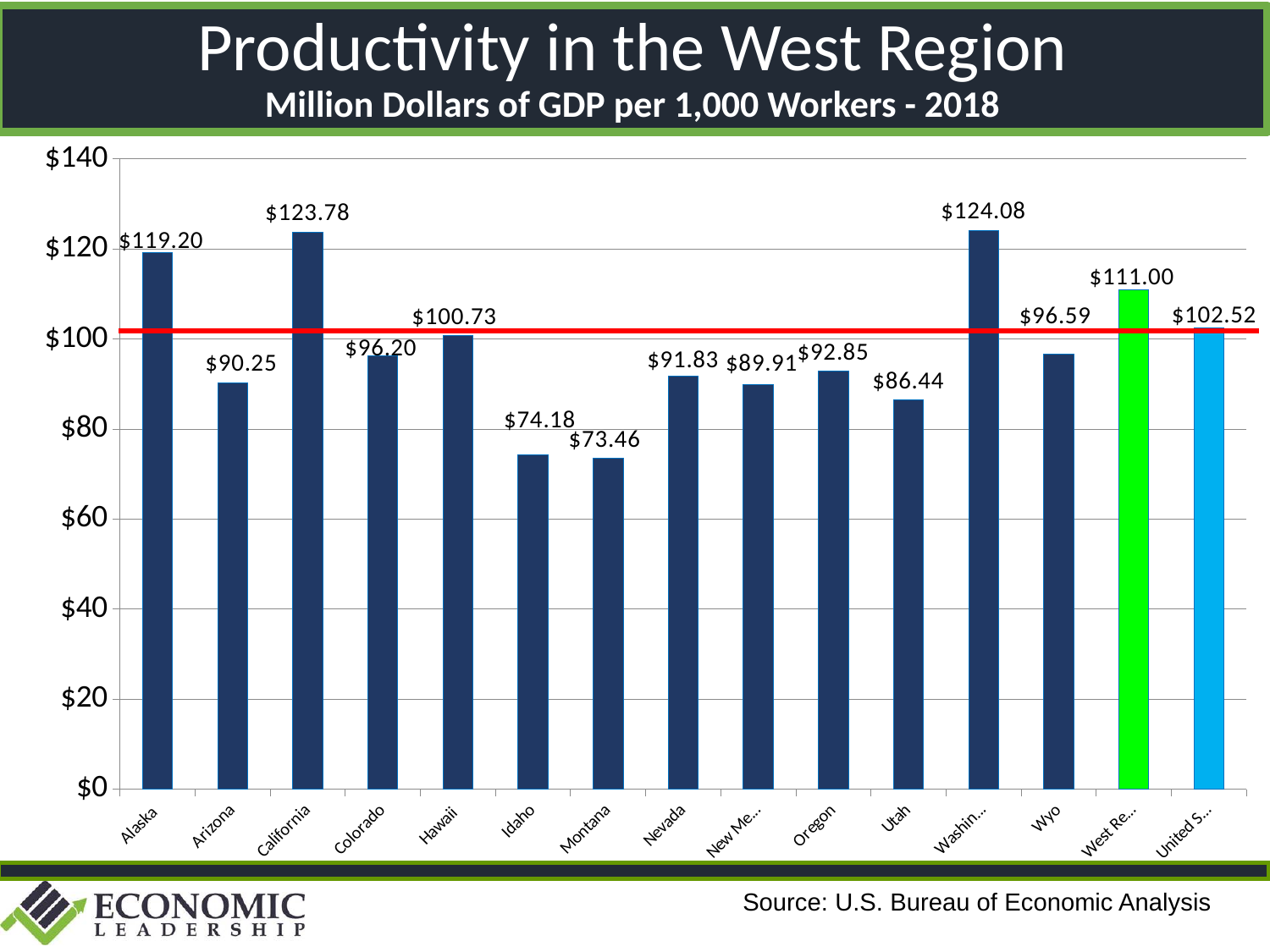
What is the value for Alaska? $119.20 Which is larger, the value for Arizona or the value for Nevada? Nevada Is the value for Alaska greater or less than $100? greater Which category has the lowest value? Montana What is the subtitle of the chart? Million Dollars of GDP per 1,000 Workers - 2018 What type of chart is shown on the slide? bar chart How many bars are plotted in the chart? 15 What is the value for Oregon? $92.85 What is the value for Hawaii? $100.73 What is the difference between the values for California and Colorado? $27.58 Is the value for Idaho greater or less than $80? less What is the value for Utah? $86.44